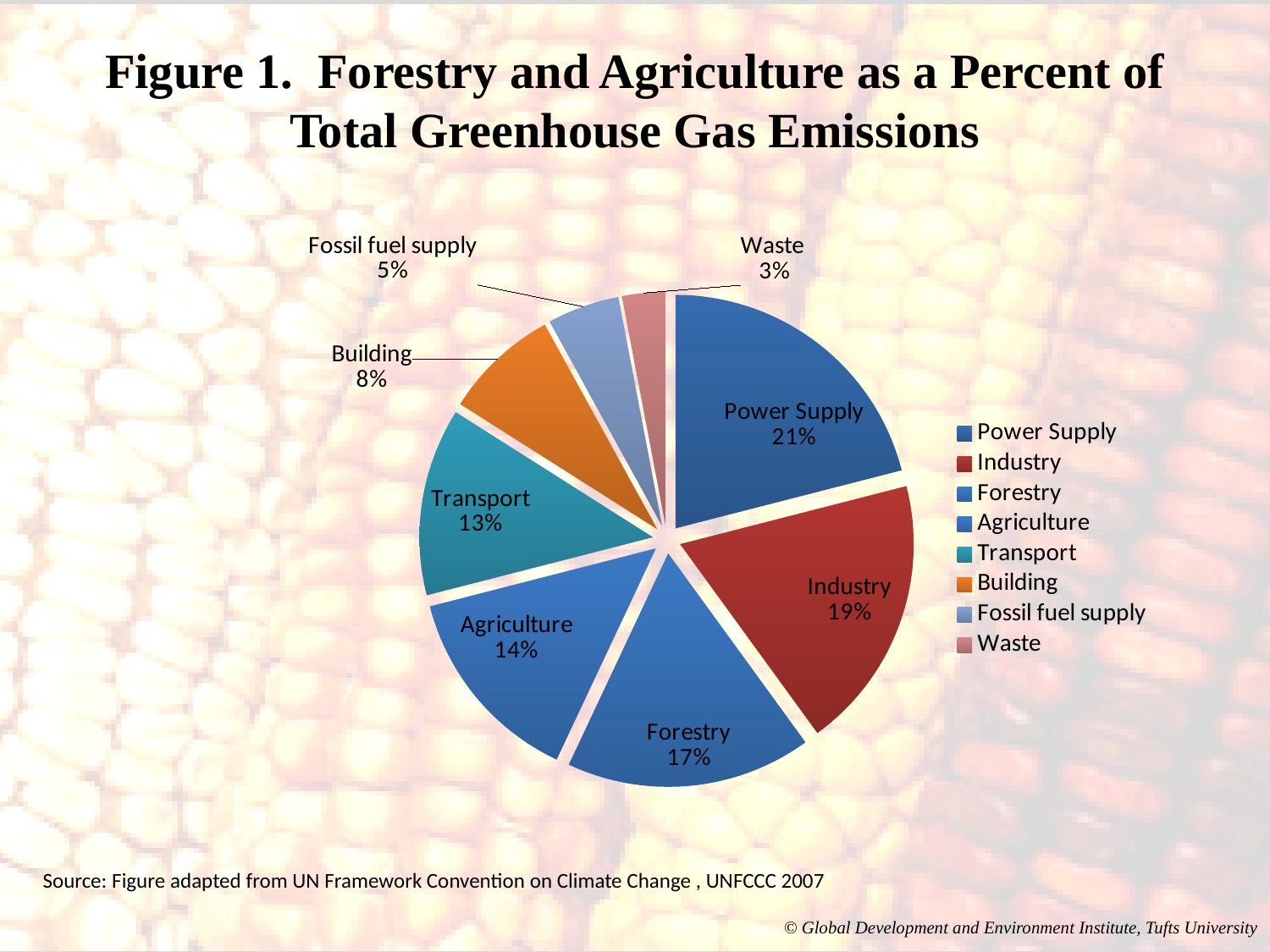
What is the combined share of Forestry and Agriculture? 31% What is the title of the figure? Figure 1. Forestry and Agriculture as a Percent of Total Greenhouse Gas Emissions What is the value shown for Forestry? 17% Which category has the smallest share of the pie? Waste Which is larger, the share for Agriculture or the share for Transport? Agriculture What is the value shown for Fossil fuel supply? 5% Which category has the largest share of the pie? Power Supply What kind of chart is shown on the slide? pie chart What percentage of total greenhouse gas emissions does Power Supply account for? 21% How many categories are shown in the pie chart? 8 What is the difference between the Industry and Building shares? 11% How many entries does the legend list? 8